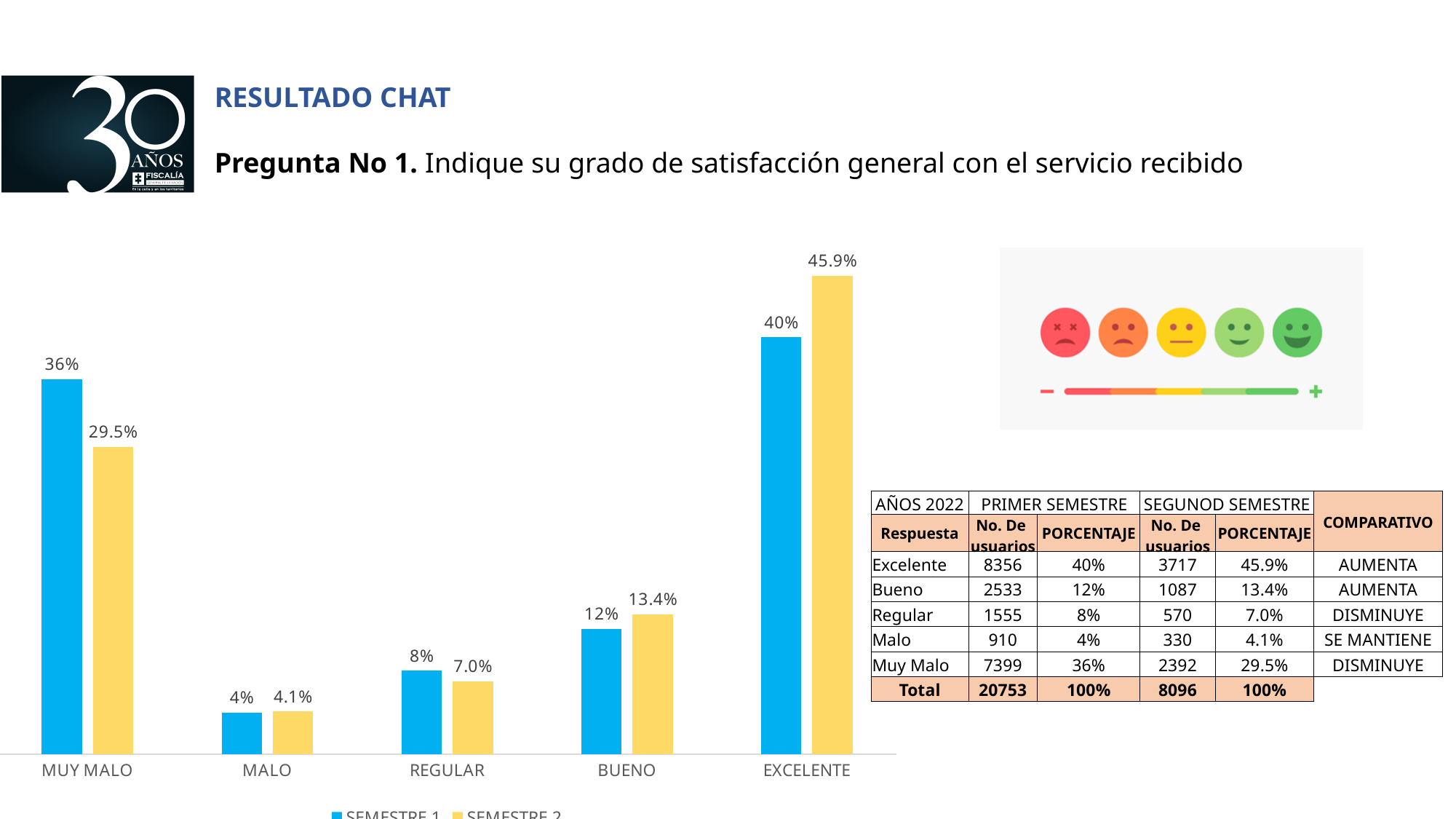
Which is larger for BUENO: the SEMESTRE 1 value or the SEMESTRE 2 value? SEMESTRE 2 What is the value for MUY MALO in the SEMESTRE 1 series? 36% How many series does the chart's legend list? 2 Which category has the highest value in the SEMESTRE 1 series? EXCELENTE What is the value for EXCELENTE in the SEMESTRE 2 series? 45.9% What is the value for BUENO in the SEMESTRE 2 series? 13.4% How many categories are shown on the x axis of the chart? 5 What kind of chart is shown on the slide? Bar chart Which category has the lowest value in the SEMESTRE 2 series? MALO What is the difference between the SEMESTRE 1 and SEMESTRE 2 values for MUY MALO? 6.5% What is the value for REGULAR in the SEMESTRE 1 series? 8% What is the difference between the SEMESTRE 2 and SEMESTRE 1 values for EXCELENTE? 5.9%